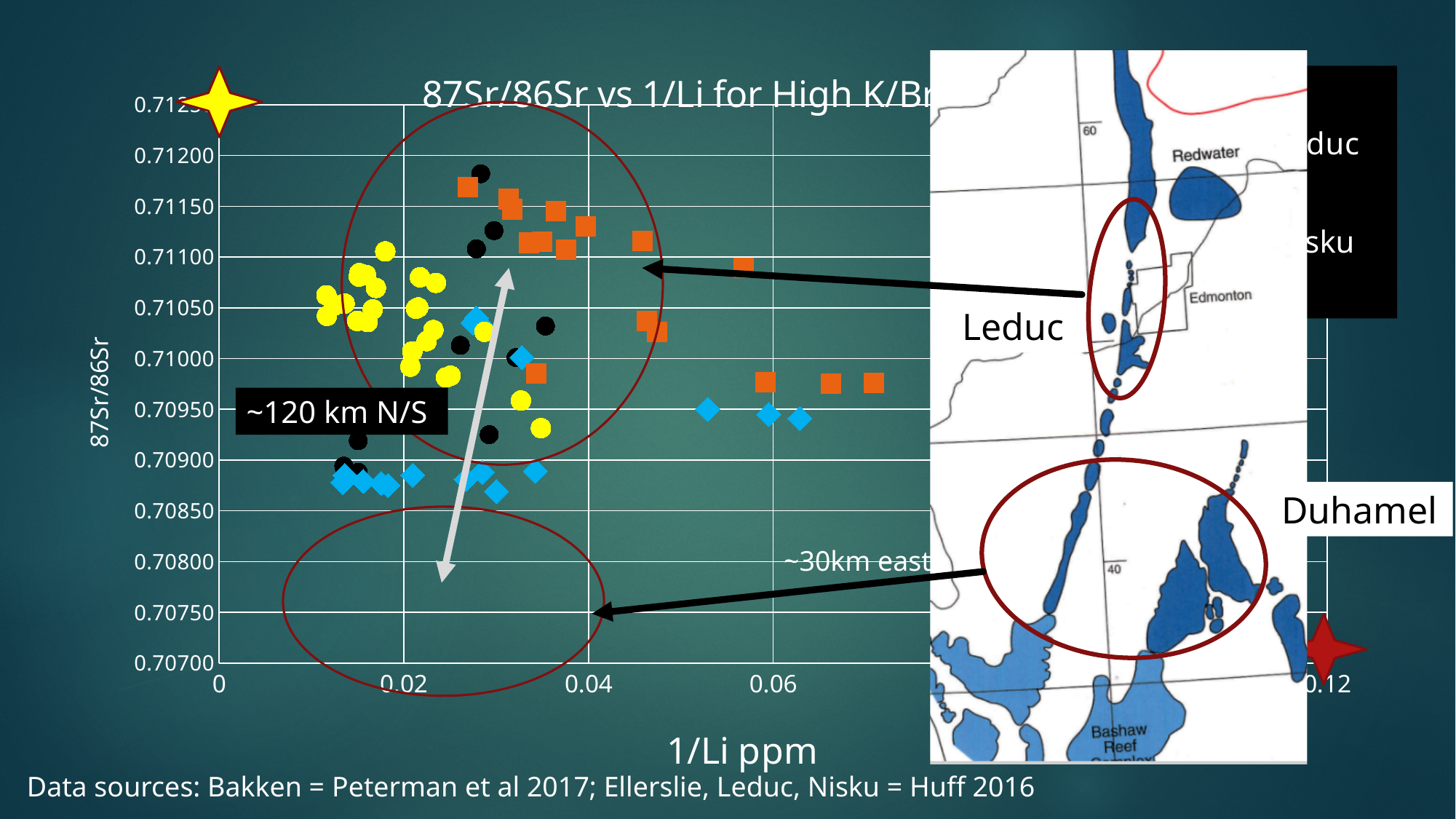
Is the rightmost yellow circle point on the chart at a 1/Li value greater or less than 0.04? less Is the lowest blue diamond point on the chart greater or less than 0.70900 on the 87Sr/86Sr axis? less What kind of chart is shown on the slide? scatter chart Is the rightmost orange square point on the chart at a 1/Li value greater or less than 0.06? greater What is the label on the x axis of the chart? 1/Li ppm What distance annotation is written next to the grey double-headed arrow on the chart? ~120 km N/S